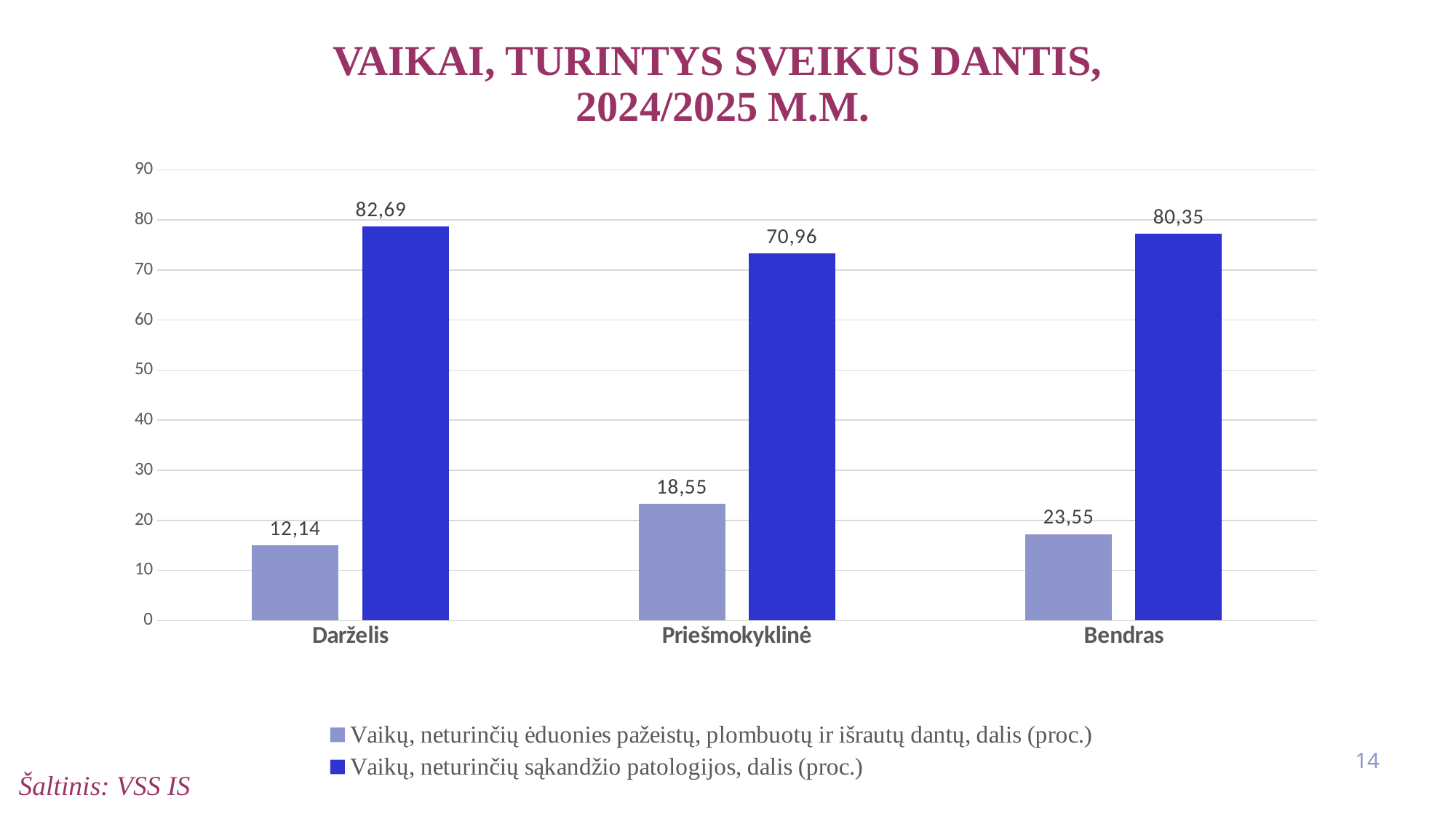
What is the value for Darželis in the series 'Vaikų, neturinčių ėduonies pažeistų, plombuotų ir išrautų dantų, dalis (proc.)'? 12,14 What kind of chart is shown on the slide? Bar chart What is the title of the chart? VAIKAI, TURINTYS SVEIKUS DANTIS, 2024/2025 M.M. What is the difference between the two series values for Priešmokyklinė? 52,41 Which is larger in the series 'Vaikų, neturinčių sąkandžio patologijos, dalis (proc.)': Priešmokyklinė or Bendras? Bendras How many categories are shown on the x axis? 3 Which category has the highest value in the series 'Vaikų, neturinčių sąkandžio patologijos, dalis (proc.)'? Darželis What is the value for Bendras in the series 'Vaikų, neturinčių ėduonies pažeistų, plombuotų ir išrautų dantų, dalis (proc.)'? 23,55 How many series does the legend list? 2 What is the value for Darželis in the series 'Vaikų, neturinčių sąkandžio patologijos, dalis (proc.)'? 82,69 Which category has the lowest value in the series 'Vaikų, neturinčių ėduonies pažeistų, plombuotų ir išrautų dantų, dalis (proc.)'? Darželis What is the value for Priešmokyklinė in the series 'Vaikų, neturinčių sąkandžio patologijos, dalis (proc.)'? 70,96